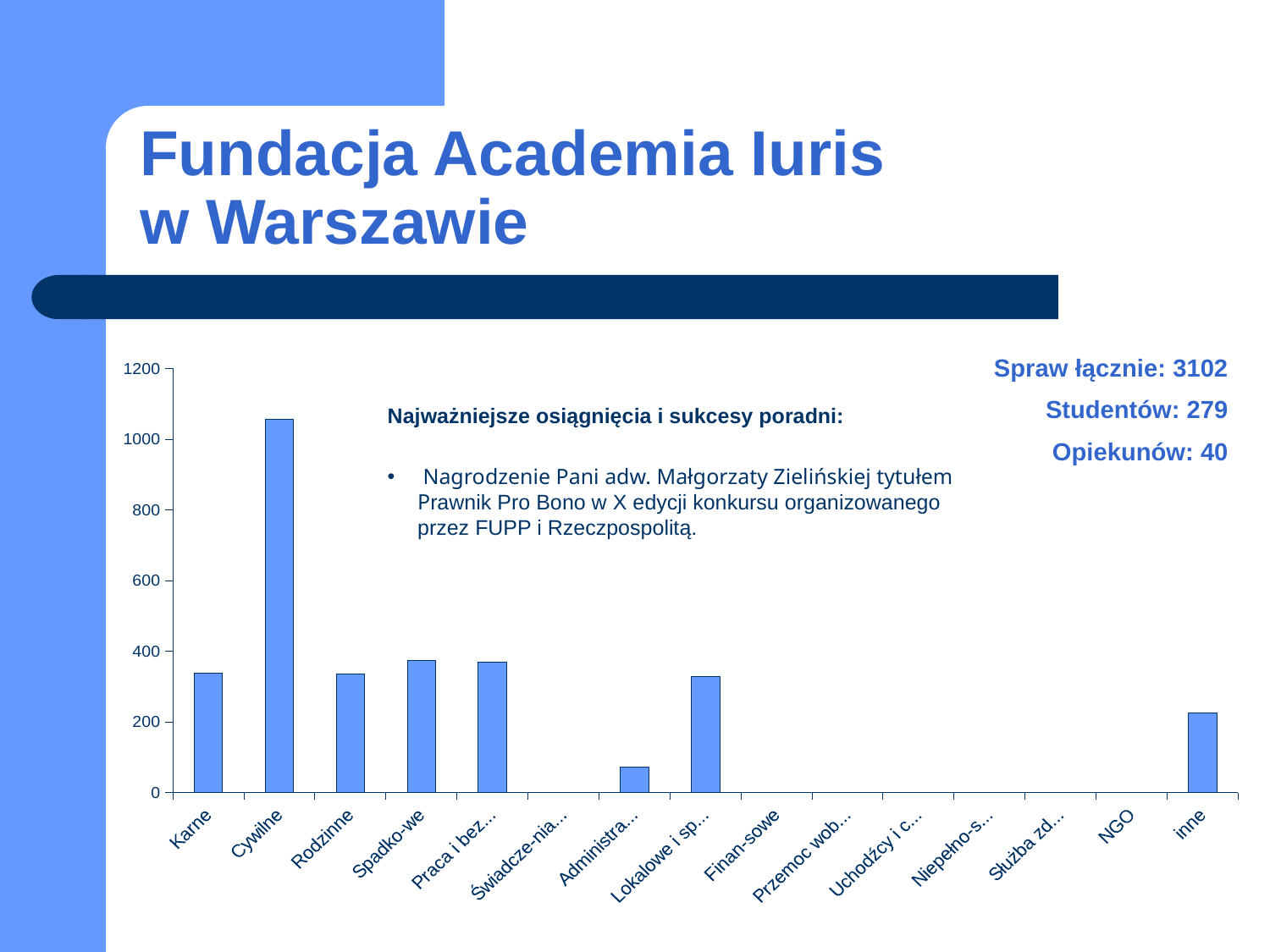
Is the value for inne greater or less than 200? greater What is the highest value shown on the y axis of the chart? 1200 Which is larger, the value for Lokalowe i sp... or the value for Administra...? Lokalowe i sp... What kind of chart is shown on the slide? bar chart Which category has the highest bar in the chart? Cywilne How many categories are shown on the x axis of the chart? 15 Which is larger, the value for Cywilne or the value for Karne? Cywilne Is the value for Karne greater or less than 400? less Is the value for Spadko-we greater or less than 200? greater Which is larger, the value for inne or the value for Administra...? inne